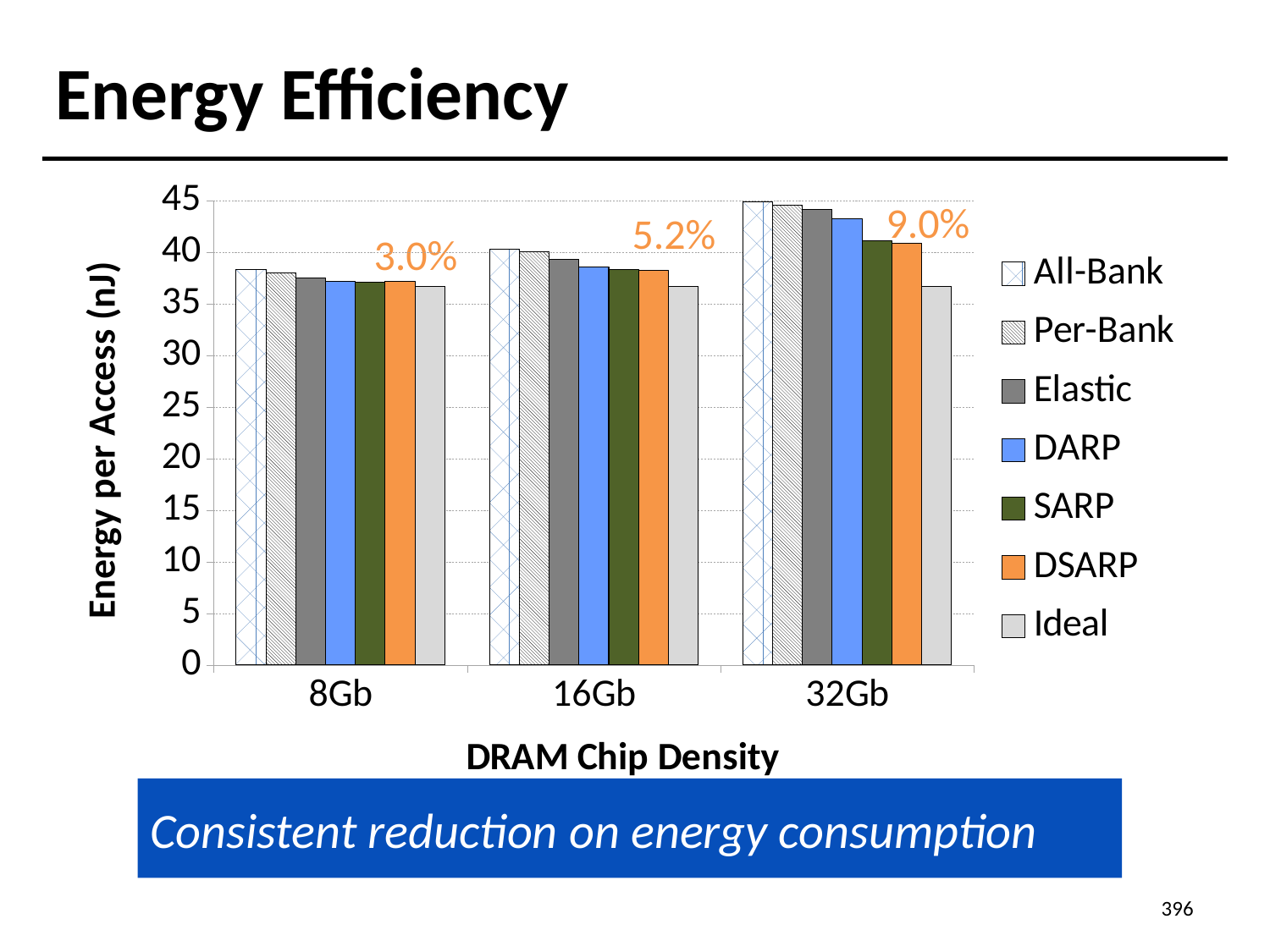
Which series has the highest energy per access at 32Gb? All-Bank Is the value for Ideal at 32Gb greater or less than 40? less Does the energy per access for All-Bank rise or fall as DRAM chip density increases from 8Gb to 32Gb? rise How many series does the legend list? 7 What kind of chart is shown on the slide? bar chart Which series has the lowest energy per access at 32Gb? Ideal Is the value for SARP at 16Gb greater or less than 40? less How many DRAM chip density categories are shown on the x axis? 3 Which is larger: the All-Bank value at 32Gb or the All-Bank value at 8Gb? All-Bank at 32Gb Is the value for All-Bank at 8Gb greater or less than 35? greater What percentage is annotated above the 32Gb group of bars? 9.0%